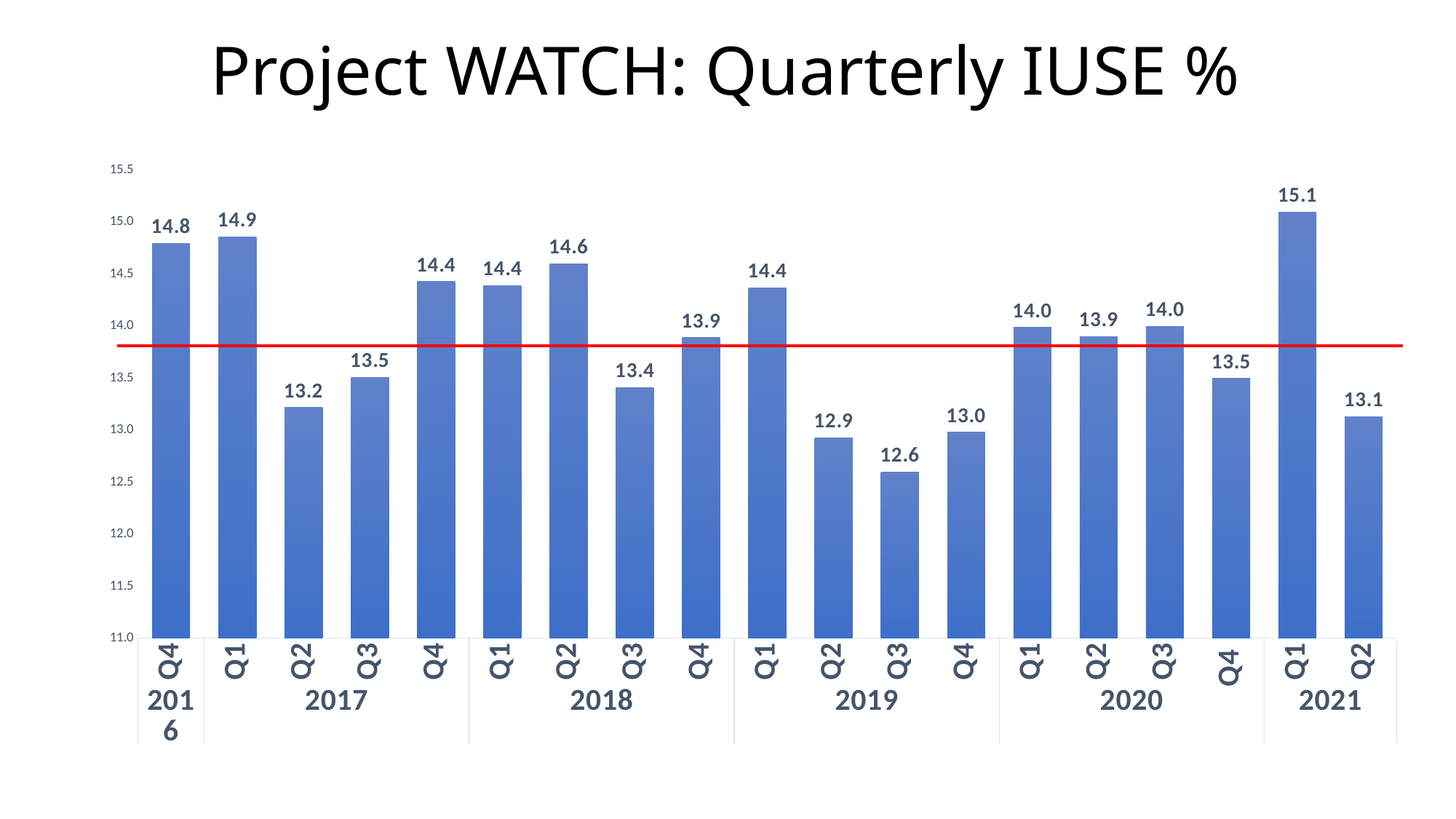
What is the difference between the IUSE % values for Q1 2021 and Q2 2021? 2.0 What type of chart is shown on the slide? bar chart Is the IUSE % value for Q2 2019 greater or less than 13.0? less What is the IUSE % value for Q1 2021? 15.1 How many quarterly bars are plotted in the chart? 19 What is the title of the chart? Project WATCH: Quarterly IUSE % What is the IUSE % value for Q2 2018? 14.6 What is the IUSE % value for Q3 2019? 12.6 Which quarter has the lowest IUSE % value? Q3 2019 What is the IUSE % value for Q4 2020? 13.5 Which is larger, the IUSE % value for Q1 2017 or Q1 2018? Q1 2017 Which quarter has the highest IUSE % value? Q1 2021